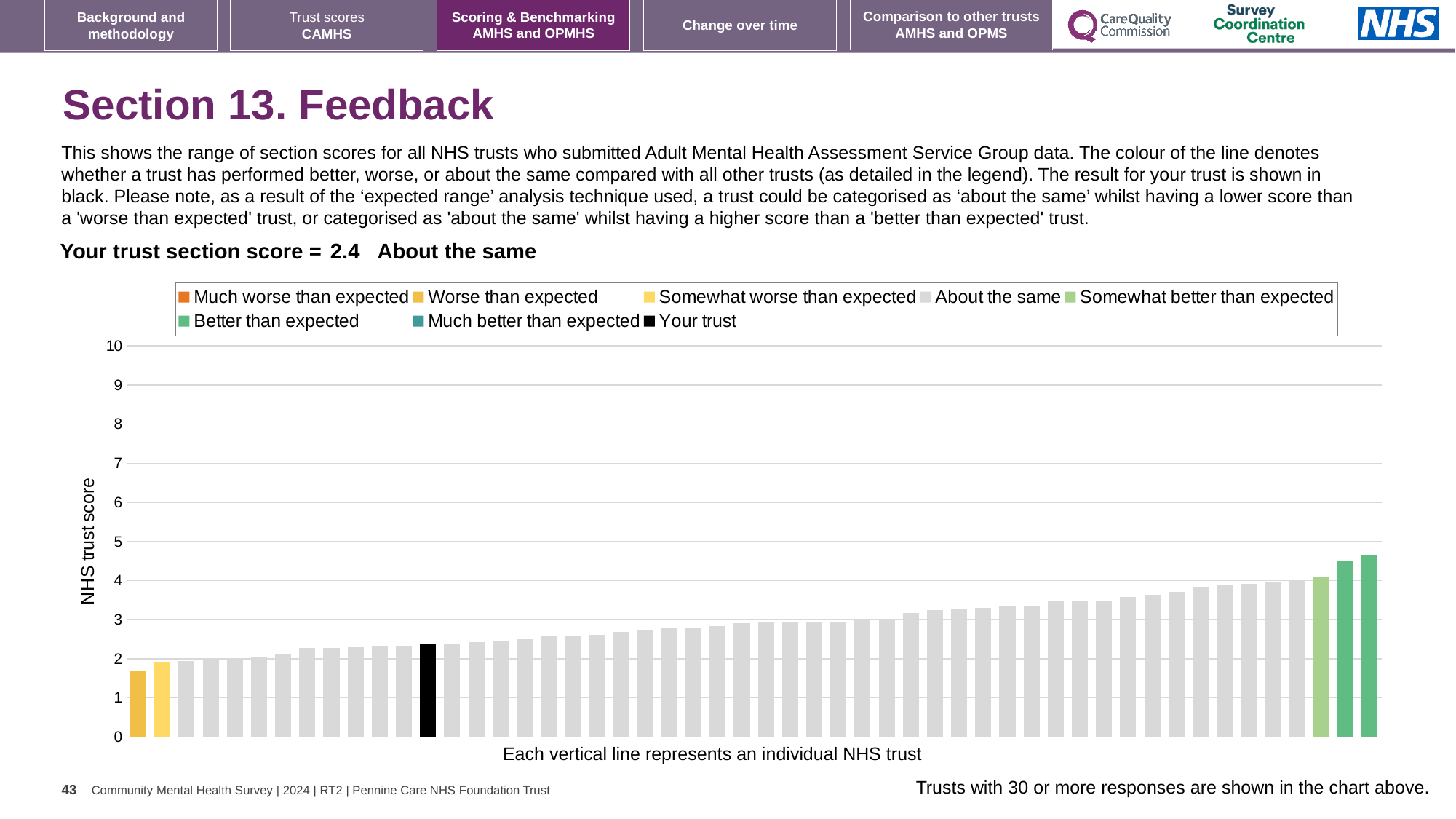
Is the value of the tallest bar in the chart greater or less than 4? greater How many bars are coloured as 'Better than expected'? 2 What kind of chart is shown on the slide? bar chart Which category is your trust's section score placed in? About the same Is the value of the shortest bar in the chart greater or less than 2? less Is the value of the black 'Your trust' bar greater or less than 3? less What is the label on the vertical axis of the chart? NHS trust score What is the section score for your trust shown on the slide? 2.4 Do the bar values rise or fall from left to right along the x axis? rise Which is larger, the black 'Your trust' bar or the leftmost bar in the chart? Your trust How many entries does the chart legend list? 8